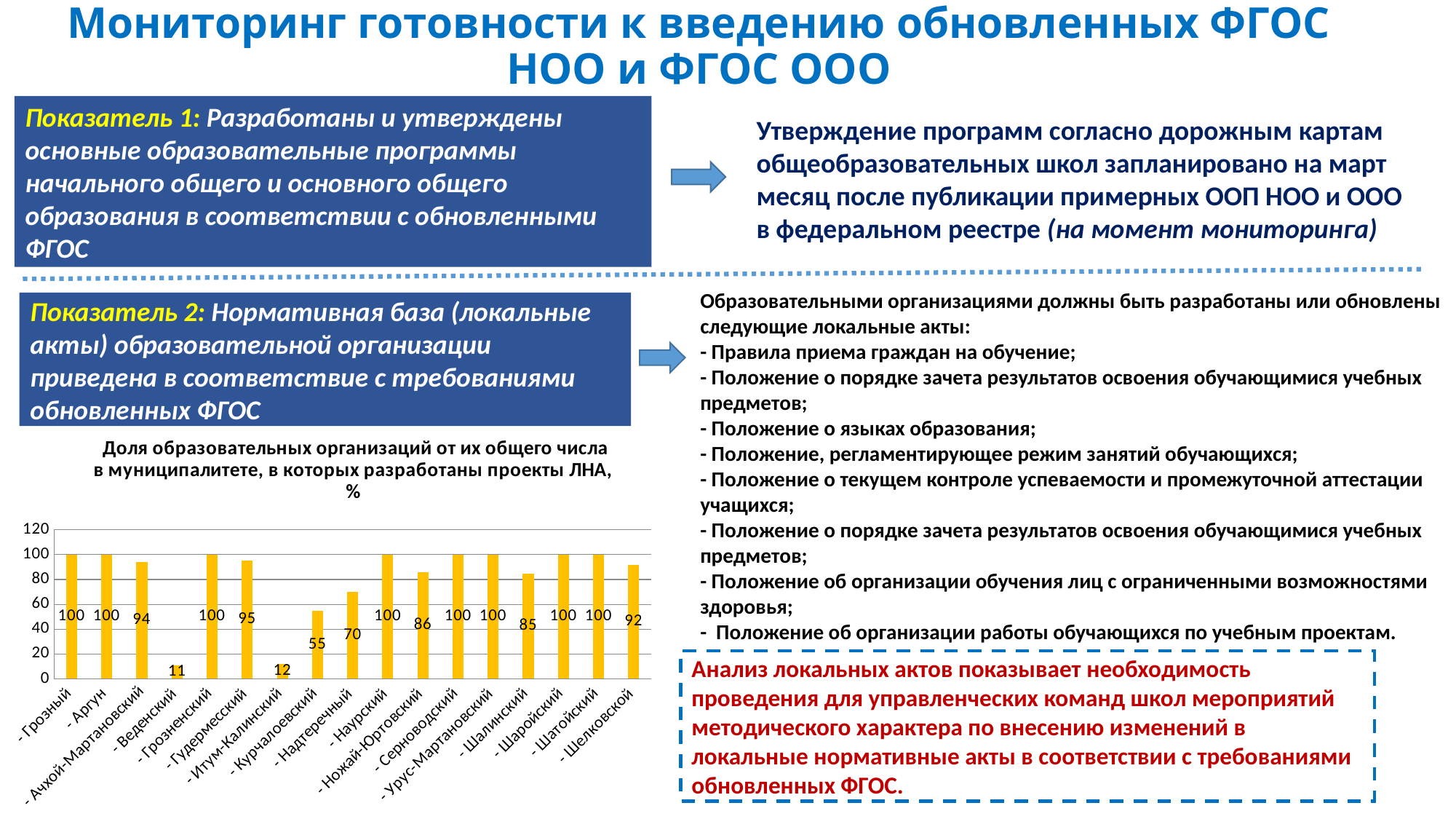
What is the value for Ножай-Юртовский in the chart? 86 Which has a larger value, Гудермесский or Шалинский? Гудермесский What is the value for Шелковской in the chart? 92 What is the value for Веденский in the chart? 11 How many municipalities have a value of 100 in the chart? 8 What is the difference between the values for Надтеречный and Итум-Калинский? 58 What type of chart is shown on the slide? bar chart What is the value for Курчалоевский in the chart? 55 What is the title of the chart? Доля образовательных организаций от их общего числа в муниципалитете, в которых разработаны проекты ЛНА, % Is the value for Курчалоевский greater or less than 60? less How many municipalities are shown on the x axis of the chart? 17 Which municipality has the lowest value in the chart? Веденский